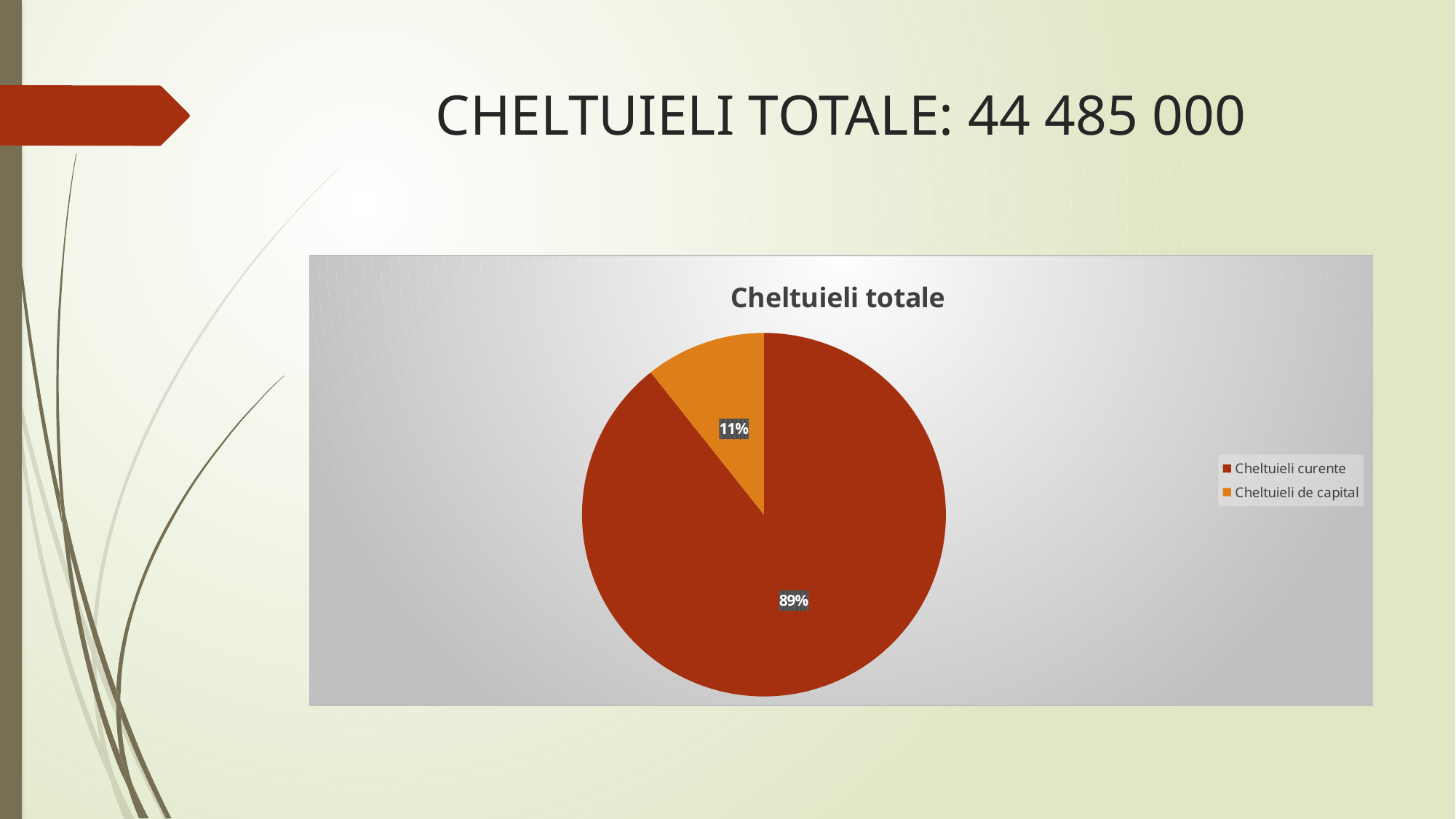
What share of the pie does Cheltuieli curente take? 89% What is the difference in percentage points between the Cheltuieli curente and Cheltuieli de capital slices? 78 Which slice is the largest in the pie chart? Cheltuieli curente What colour is the Cheltuieli de capital slice? orange Which slice is the smallest in the pie chart? Cheltuieli de capital What share of the pie does Cheltuieli de capital take? 11% What is the title of the chart? Cheltuieli totale What total expenditure figure is given in the slide title? 44 485 000 How many entries does the legend list? 2 Which is larger, the Cheltuieli curente slice or the Cheltuieli de capital slice? Cheltuieli curente How many slices does the pie chart have? 2 What kind of chart is shown on the slide? pie chart